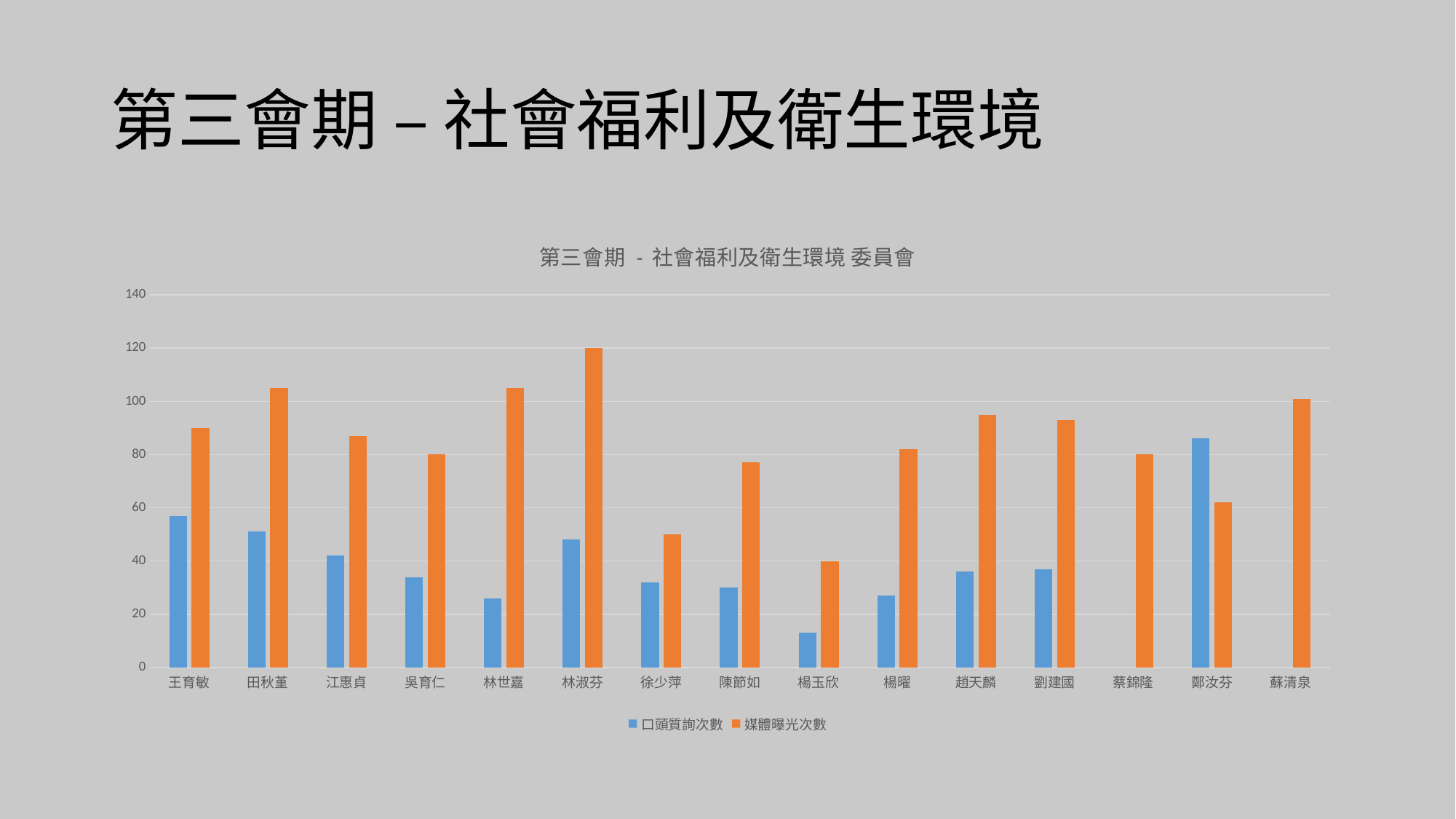
Is the 媒體曝光次數 value for 田秋堇 greater or less than 100? greater Which legislator has the lowest 媒體曝光次數? 楊玉欣 Which legislator has the highest 口頭質詢次數? 鄭汝芬 Which has the larger 媒體曝光次數: 田秋堇 or 江惠貞? 田秋堇 What kind of chart is shown on the slide? bar chart For 鄭汝芬, which is larger: 口頭質詢次數 or 媒體曝光次數? 口頭質詢次數 Is the 口頭質詢次數 value for 王育敏 greater or less than 60? less How many legislators (categories) are shown on the x axis? 15 Is the 口頭質詢次數 value for 楊玉欣 greater or less than 20? less Which legislator has the highest 媒體曝光次數? 林淑芬 What colour are the bars for 媒體曝光次數? orange How many series does the legend list? 2